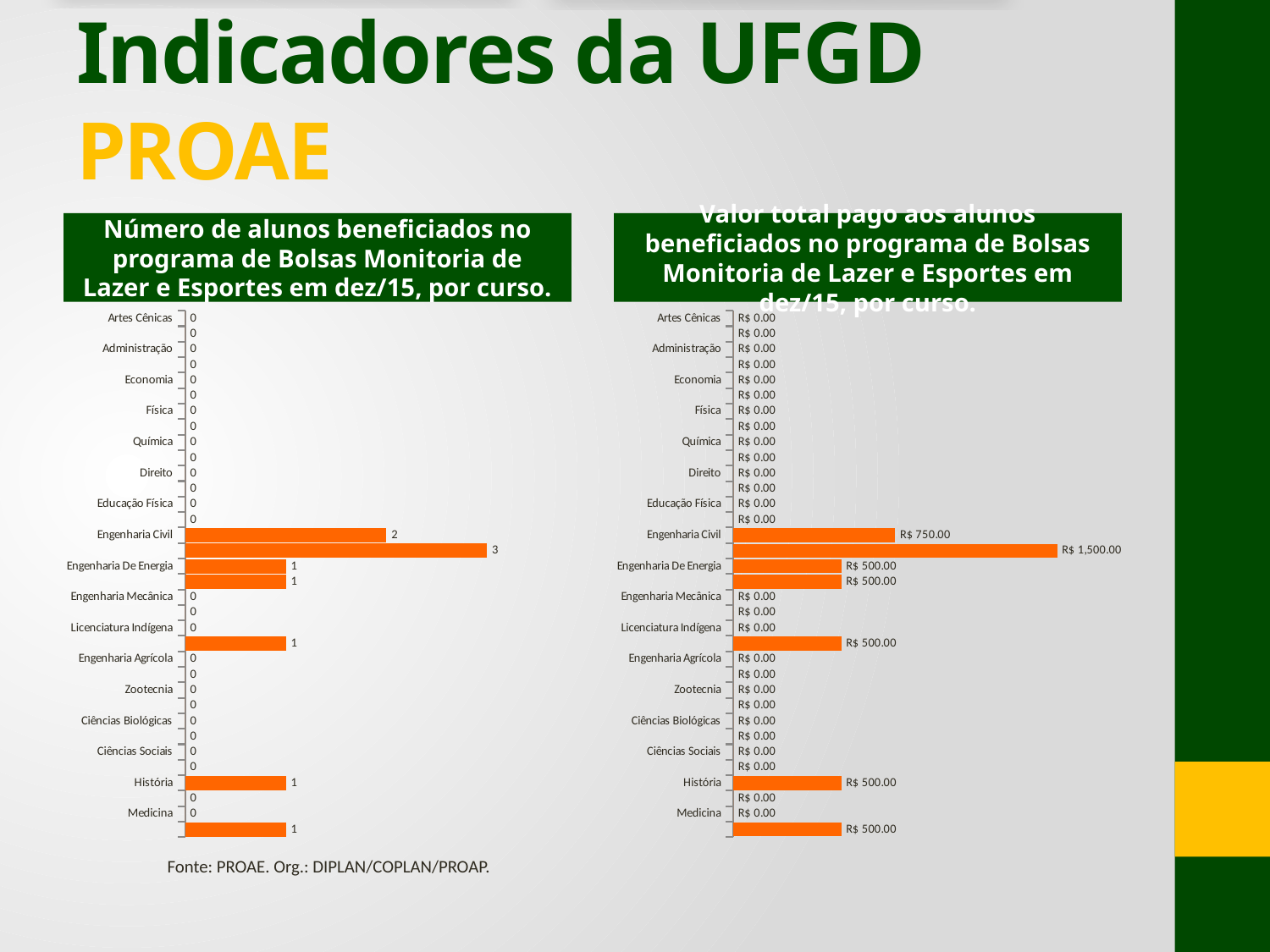
In the right chart (Valor total pago aos alunos), what is the value of the upper bar for História? R$ 500.00 What kind of chart is the left chart, 'Número de alunos beneficiados no programa de Bolsas Monitoria de Lazer e Esportes em dez/15, por curso'? Bar chart How many courses are listed on the category axis of the left chart (Número de alunos beneficiados)? 17 In the right chart (Valor total pago aos alunos), what is the value of the upper bar for Engenharia Civil? R$ 750.00 In the left chart (Número de alunos beneficiados), what is the value of the upper bar for Engenharia Civil? 2